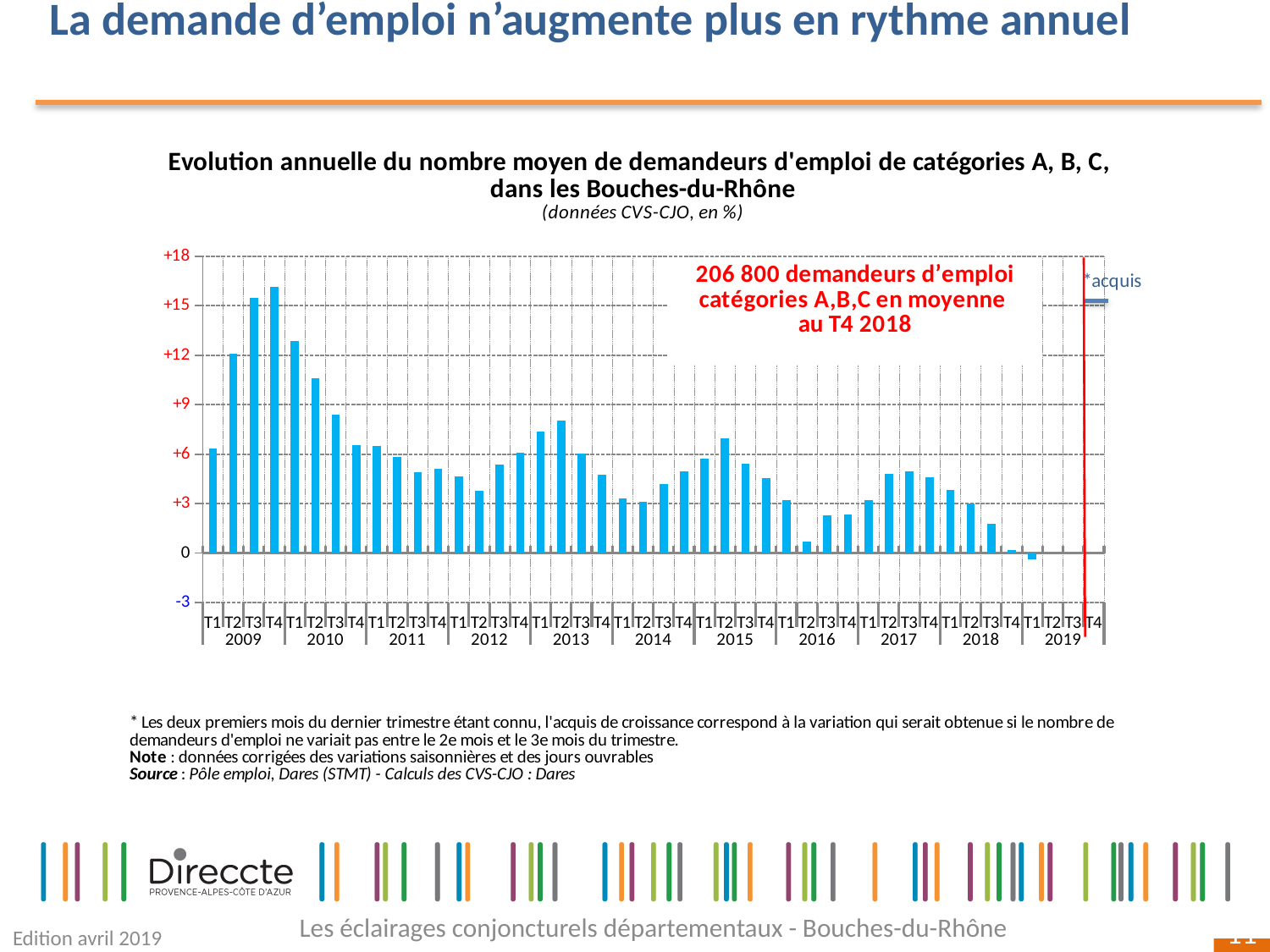
Is the value for T2 2010 greater or less than +9? greater Which is larger, the value for T4 2009 or the value for T1 2010? T4 2009 According to the red text on the chart, how many job seekers in categories A, B, C were there on average in T4 2018? 206 800 Is the value for T1 2014 greater or less than +6? less How many bars on the chart are below zero? 1 Is the value for T4 2009 greater or less than +15? greater In which year does the highest bar of the chart occur? 2009 What kind of chart is shown on the slide? bar chart Do the values rise or fall from T4 2009 to T4 2010? fall Which quarter has the lowest (only negative) bar on the chart? T1 2019 Which is larger, the value for T2 2016 or the value for T2 2017? T2 2017